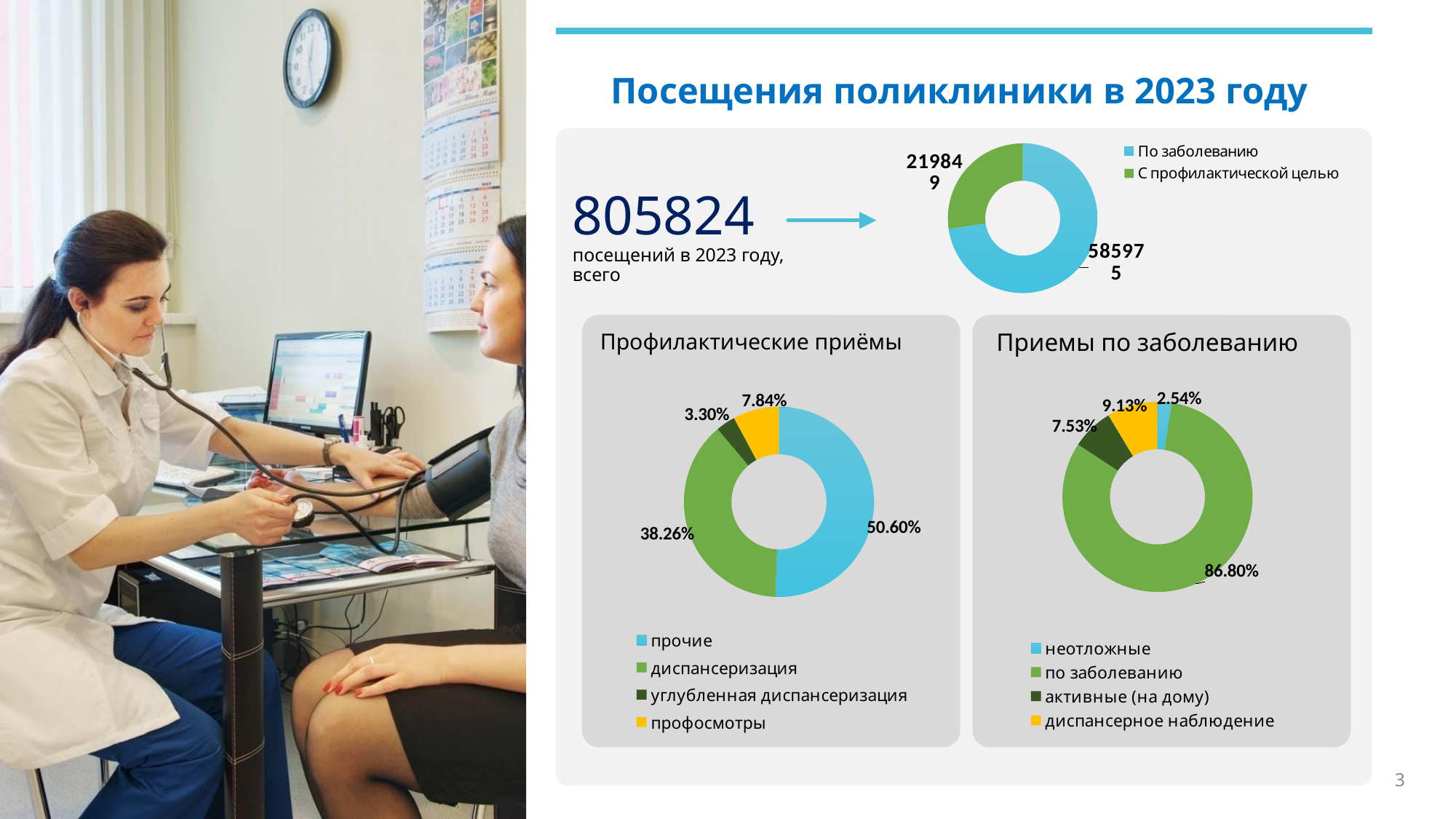
In the 'Профилактические приёмы' chart, what is the difference between the shares of 'прочие' and 'диспансеризация'? 12.34% In the 'Приемы по заболеванию' chart, which is larger: 'активные (на дому)' or 'диспансерное наблюдение'? диспансерное наблюдение In the 'Приемы по заболеванию' chart, what share is 'диспансерное наблюдение'? 9.13% How many categories does the legend of the 'Приемы по заболеванию' chart list? 4 What total number of visits in 2023 is shown on the slide? 805824 In the top donut chart, which category is larger: 'По заболеванию' or 'С профилактической целью'? По заболеванию In the 'Приемы по заболеванию' chart, what share is 'по заболеванию'? 86.80% In the 'Профилактические приёмы' chart, which category has the smallest share? углубленная диспансеризация What kind of chart is used for 'Профилактические приёмы'? Donut (pie) chart In the 'Профилактические приёмы' chart, what share is 'диспансеризация'? 38.26% In the 'Профилактические приёмы' chart, what share is 'прочие'? 50.60% In the 'Приемы по заболеванию' chart, which category has the smallest share? неотложные